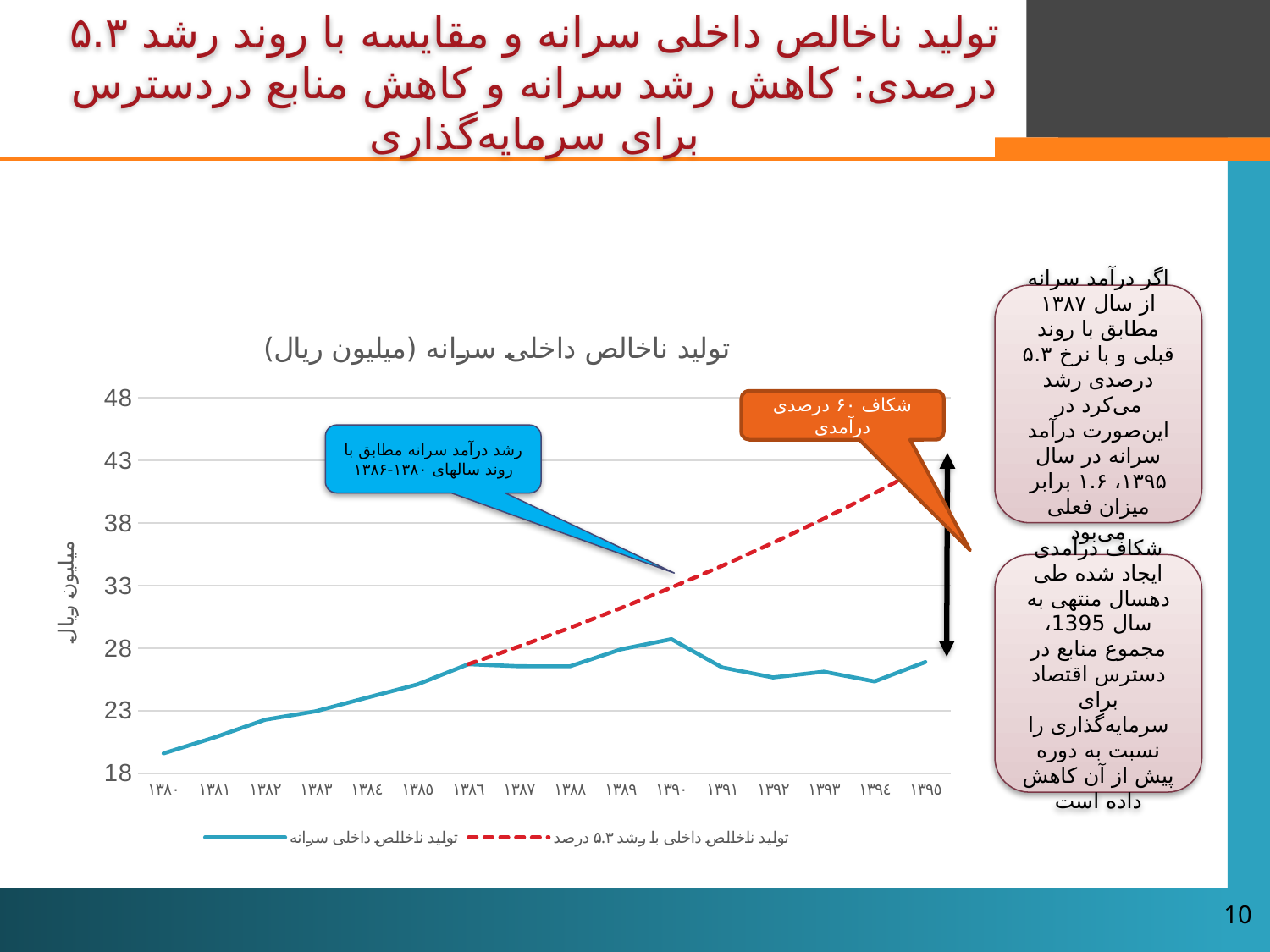
How many series does the chart legend list? 2 What is the label on the vertical axis of the chart? میلیون ریال How many years are shown along the x axis of the chart? 16 Is the value of the dashed line (تولید ناخالص داخلی با رشد ۵.۳ درصد) for ۱۳۹۵ greater or less than 38? greater In which year does the solid line (تولید ناخالص داخلی سرانه) have its lowest value? ۱۳۸۰ Is the value of the solid line (تولید ناخالص داخلی سرانه) for ۱۳۹۵ greater or less than 28? less In which year does the solid line (تولید ناخالص داخلی سرانه) reach its highest value? ۱۳۹۰ Does the solid line (تولید ناخالص داخلی سرانه) rise or fall from ۱۳۹۰ to ۱۳۹۴? fall What kind of chart is shown on the slide? line chart Is the value of the solid line (تولید ناخالص داخلی سرانه) for ۱۳۸۰ greater or less than 23? less At ۱۳۹۵, which series has the larger value: the dashed line (تولید ناخالص داخلی با رشد ۵.۳ درصد) or the solid line (تولید ناخالص داخلی سرانه)? the dashed line (تولید ناخالص داخلی با رشد ۵.۳ درصد) What is the title of the chart? تولید ناخالص داخلی سرانه (میلیون ریال)